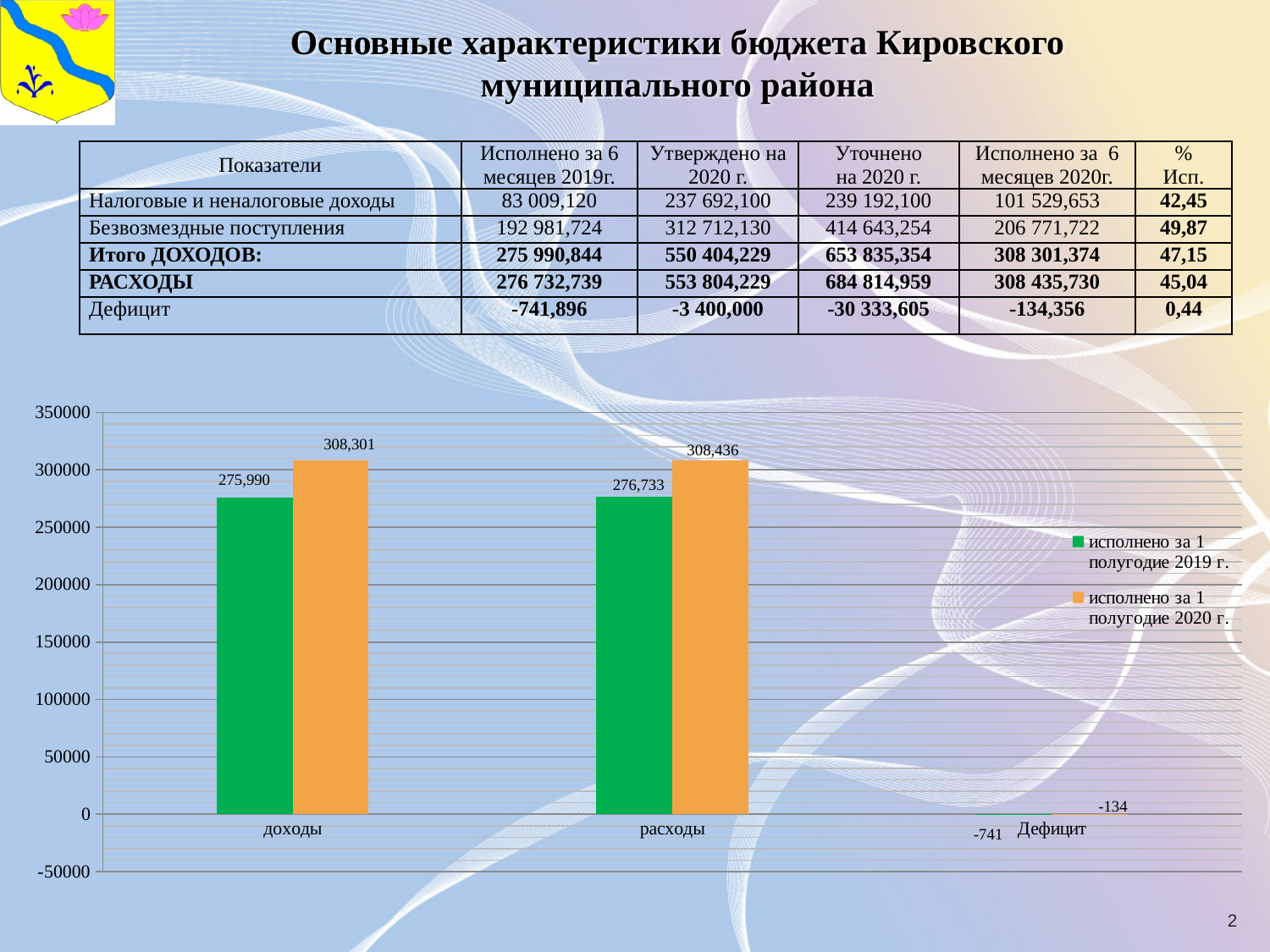
Which colour represents the series исполнено за 1 полугодие 2020 г. in the chart? orange What is the difference between the 2020 and 2019 values for доходы in the chart? 32,311 What is the value for расходы in the series исполнено за 1 полугодие 2020 г.? 308,436 What is the value for доходы in the series исполнено за 1 полугодие 2020 г.? 308,301 Which category has the lowest value in the series исполнено за 1 полугодие 2020 г.? Дефицит What is the value for доходы in the series исполнено за 1 полугодие 2019 г.? 275,990 What type of chart is shown on the slide? bar chart How many categories are shown on the x axis of the chart? 3 What is the value for Дефицит in the series исполнено за 1 полугодие 2019 г.? -741 How many series does the chart legend list? 2 What is the value for расходы in the series исполнено за 1 полугодие 2019 г.? 276,733 What is the value for Дефицит in the series исполнено за 1 полугодие 2020 г.? -134